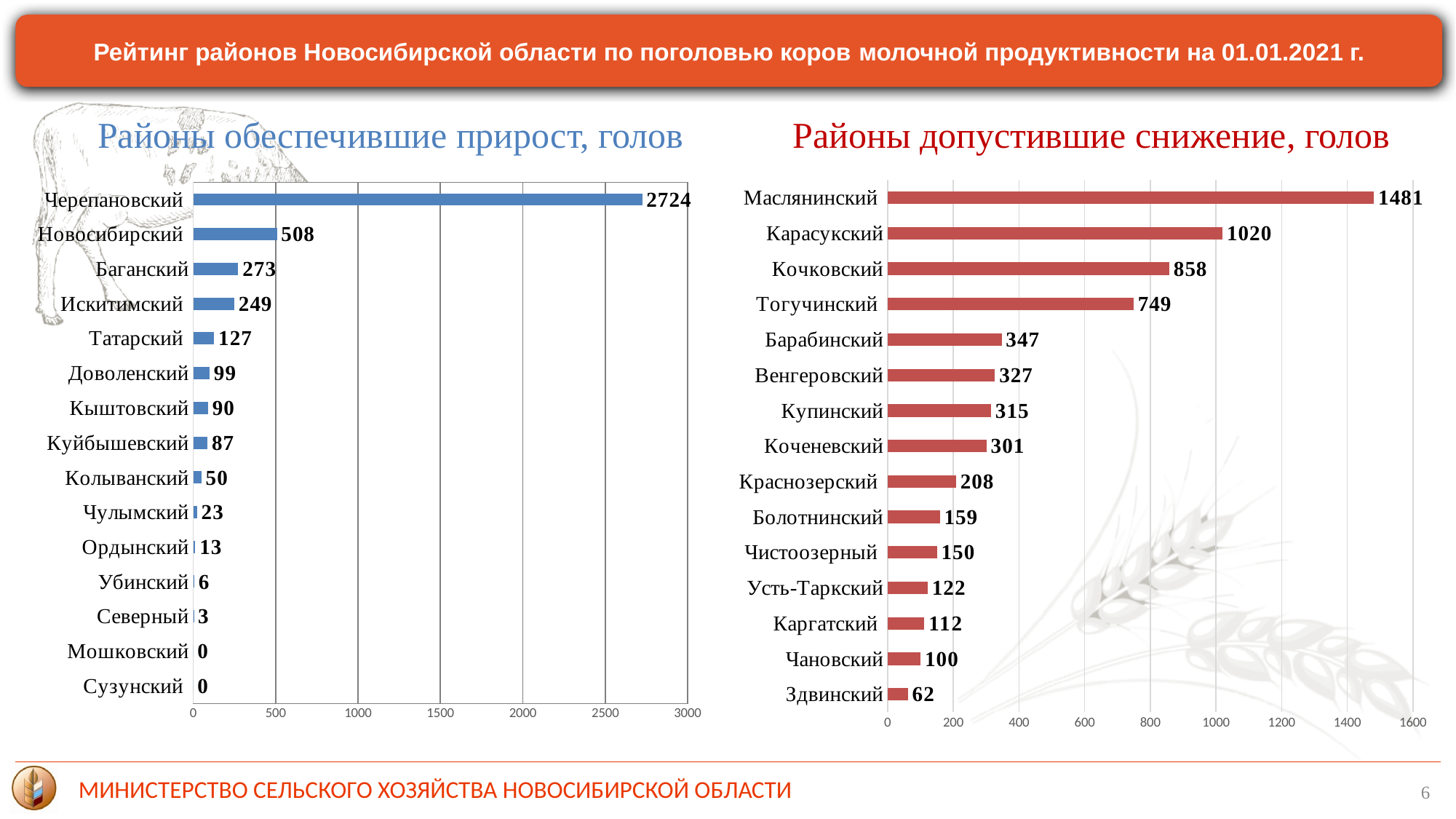
In the right chart (Районы допустившие снижение, голов), what is the value for Кочковский? 858 In the right chart (Районы допустившие снижение, голов), which district has the highest value? Маслянинский In the right chart (Районы допустившие снижение, голов), what is the difference between Маслянинский and Карасукский? 461 How many districts are shown in the left chart (Районы обеспечившие прирост, голов)? 15 What colour are the bars in the left chart (Районы обеспечившие прирост, голов)? blue In the right chart (Районы допустившие снижение, голов), which district has the lowest value? Здвинский In the left chart (Районы обеспечившие прирост, голов), which is larger, Искитимский or Татарский? Искитимский In the left chart (Районы обеспечившие прирост, голов), what is the difference between Новосибирский and Баганский? 235 What type of chart is the right chart (Районы допустившие снижение, голов)? bar chart In the left chart (Районы обеспечившие прирост, голов), what is the value for Черепановский? 2724 How many districts are shown in the right chart (Районы допустившие снижение, голов)? 15 In the right chart (Районы допустившие снижение, голов), is the value for Тогучинский greater or less than 600? greater